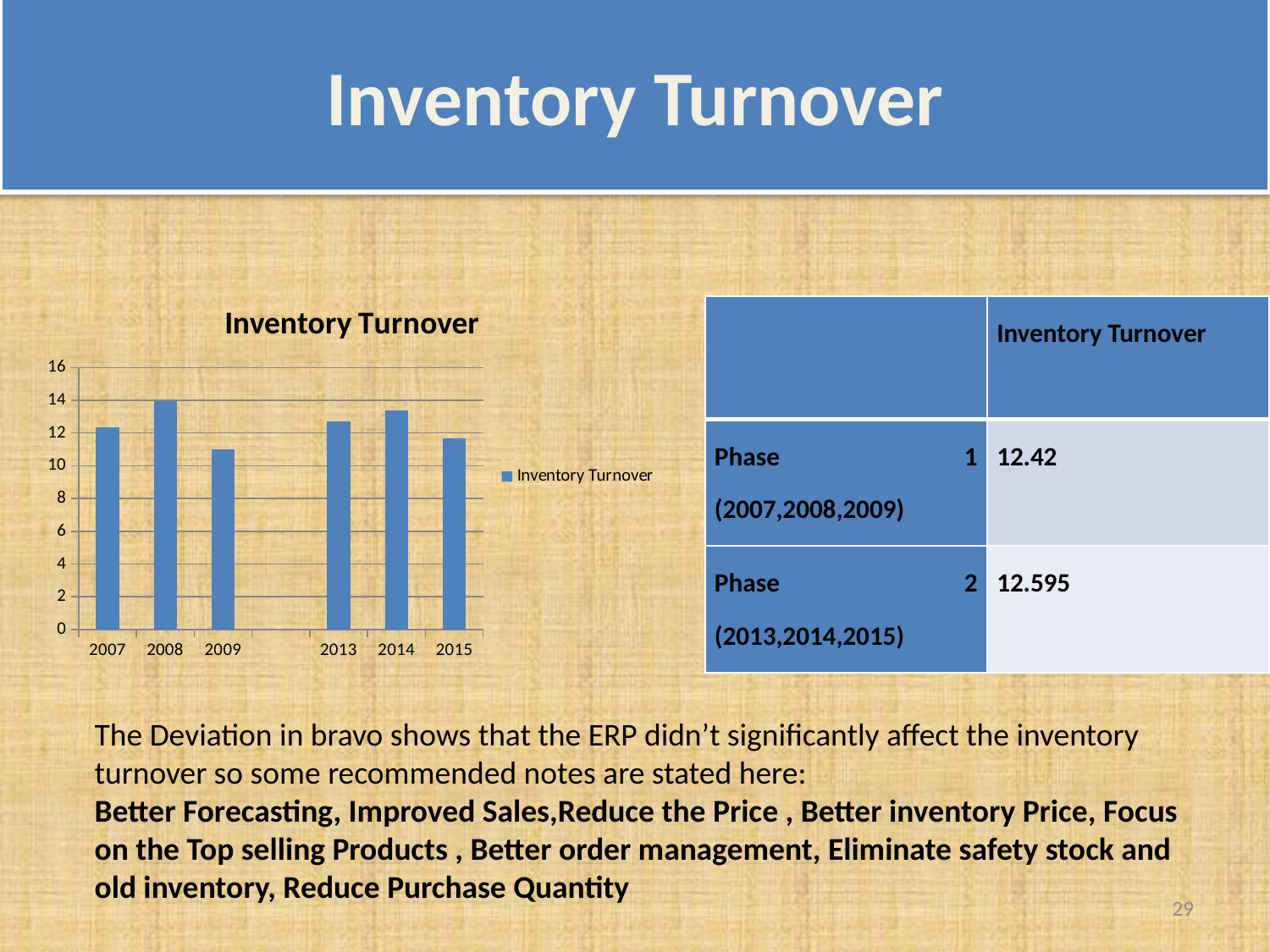
Is the value for 2014 greater or less than 12? greater How many series does the chart legend list? 1 Is the value for 2008 greater or less than 12? greater How many years are plotted on the x axis of the chart? 6 Is the value for 2015 greater or less than 10? greater What is the name of the series shown in the chart legend? Inventory Turnover What type of chart is shown on the slide? bar chart What is the title of the chart? Inventory Turnover Which is larger in the chart, the value for 2014 or the value for 2015? 2014 Which is larger in the chart, the value for 2008 or the value for 2009? 2008 Which year has the highest inventory turnover in the chart? 2008